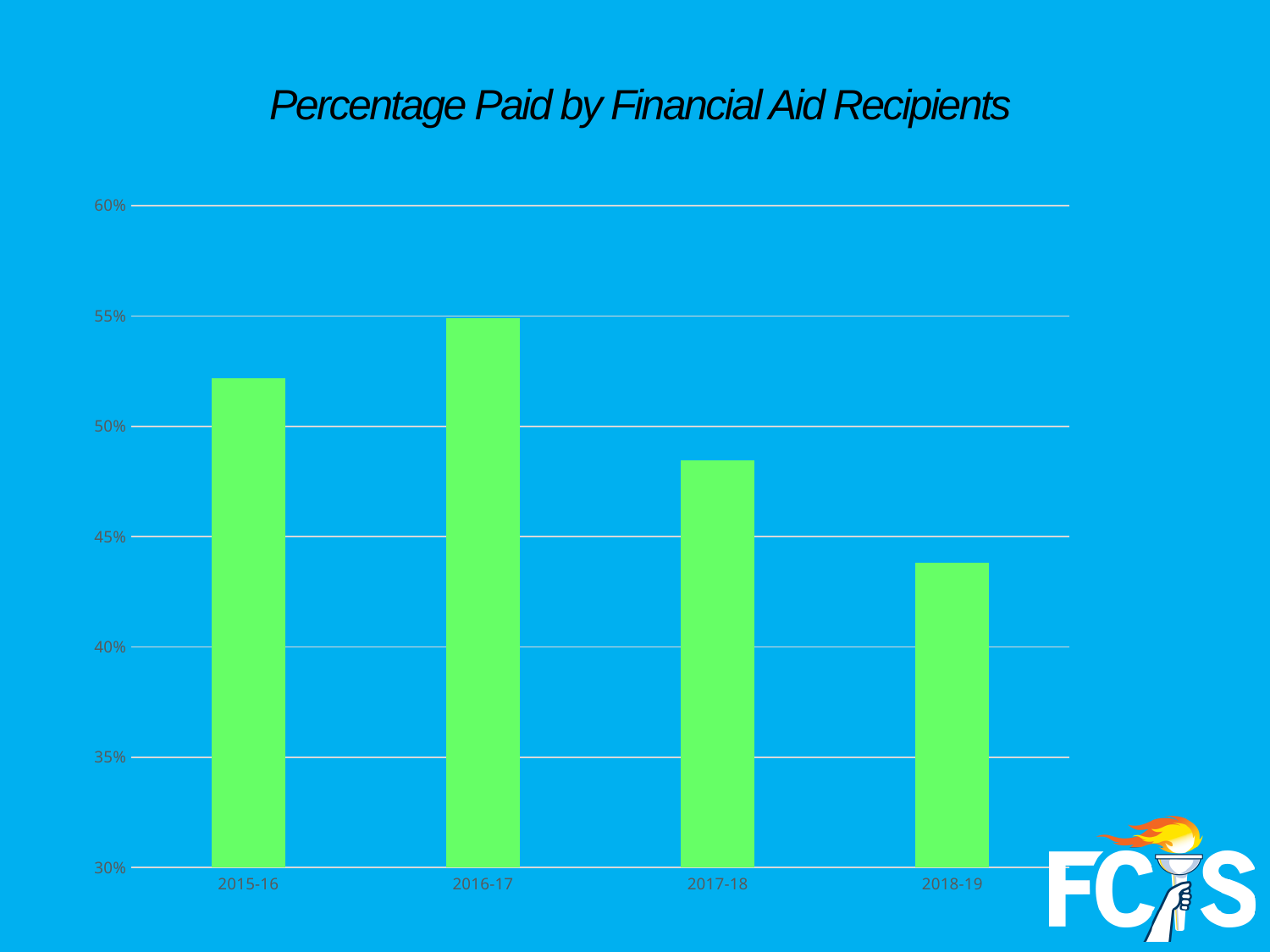
What kind of chart is shown on the slide? bar chart How many academic years are shown on the x axis? 4 What is the title of the chart? Percentage Paid by Financial Aid Recipients Is the value for 2017-18 greater or less than 50%? less Which year has the highest percentage paid by financial aid recipients? 2016-17 What colour are the bars in the chart? green Which is larger, the value for 2015-16 or the value for 2017-18? 2015-16 Is the value for 2015-16 greater or less than 50%? greater Is the value for 2018-19 greater or less than 40%? greater Do the values rise or fall from 2016-17 through 2018-19? fall Which year has the lowest percentage paid by financial aid recipients? 2018-19